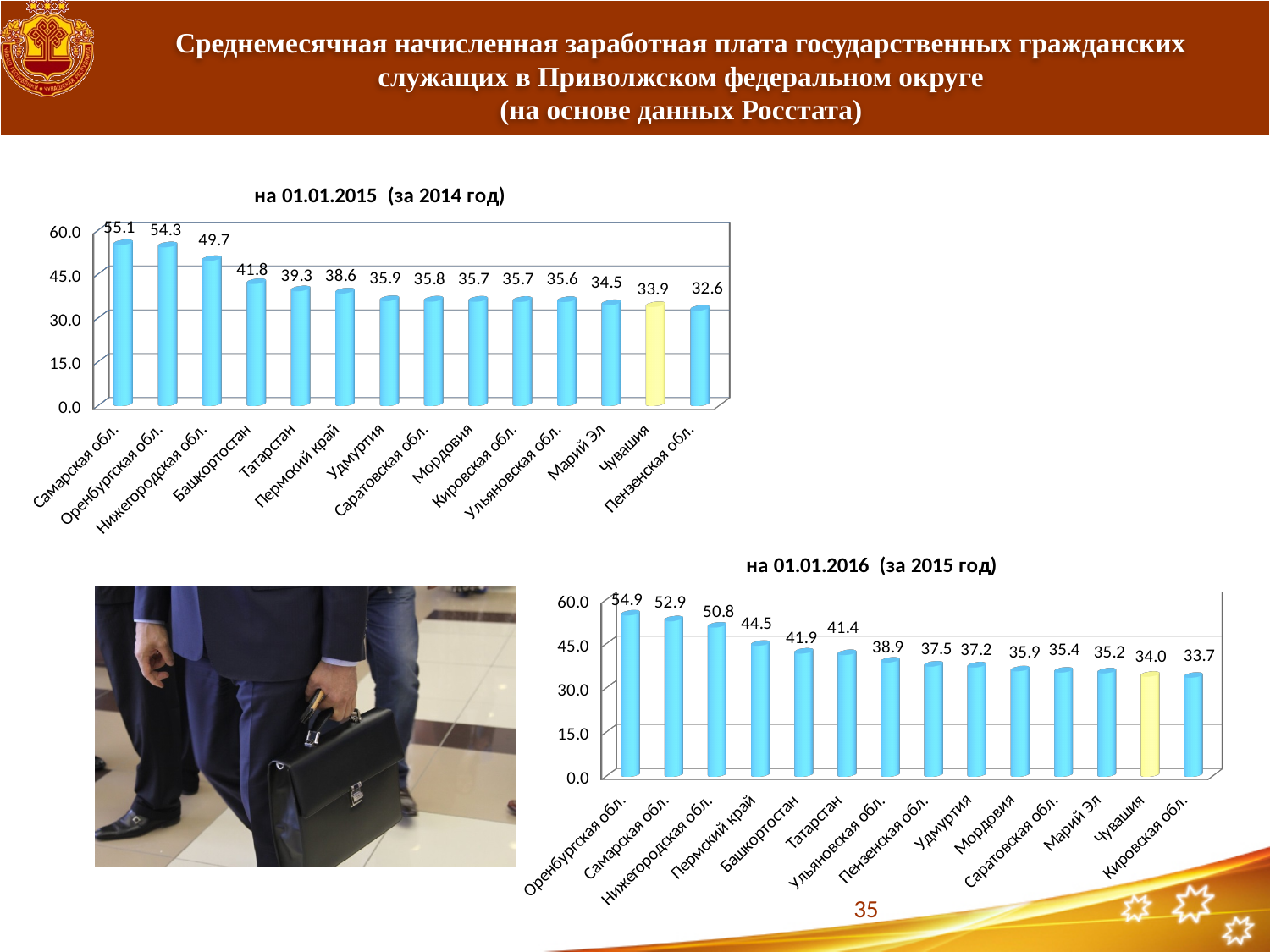
What kind of chart is the chart titled "на 01.01.2016 (за 2015 год)"? bar chart In the chart titled "на 01.01.2016 (за 2015 год)", what is the value for Пермский край? 44.5 In the chart titled "на 01.01.2015 (за 2014 год)", what is the value for Чувашия? 33.9 In the chart titled "на 01.01.2016 (за 2015 год)", what is the value for Оренбургская обл.? 54.9 In the chart titled "на 01.01.2015 (за 2014 год)", what is the difference between the values for Самарская обл. and Пензенская обл.? 22.5 In the chart titled "на 01.01.2016 (за 2015 год)", which category has the lowest value? Кировская обл. In the chart titled "на 01.01.2016 (за 2015 год)", which is larger: the value for Башкортостан or the value for Татарстан? Башкортостан In the chart titled "на 01.01.2016 (за 2015 год)", which bar is coloured yellow instead of blue? Чувашия In the chart titled "на 01.01.2015 (за 2014 год)", do the values rise or fall from left to right along the x axis? fall How many categories are shown in the chart titled "на 01.01.2015 (за 2014 год)"? 14 In the chart titled "на 01.01.2016 (за 2015 год)", is the value for Нижегородская обл. greater or less than 45.0? greater In the chart titled "на 01.01.2015 (за 2014 год)", which category has the highest value? Самарская обл.